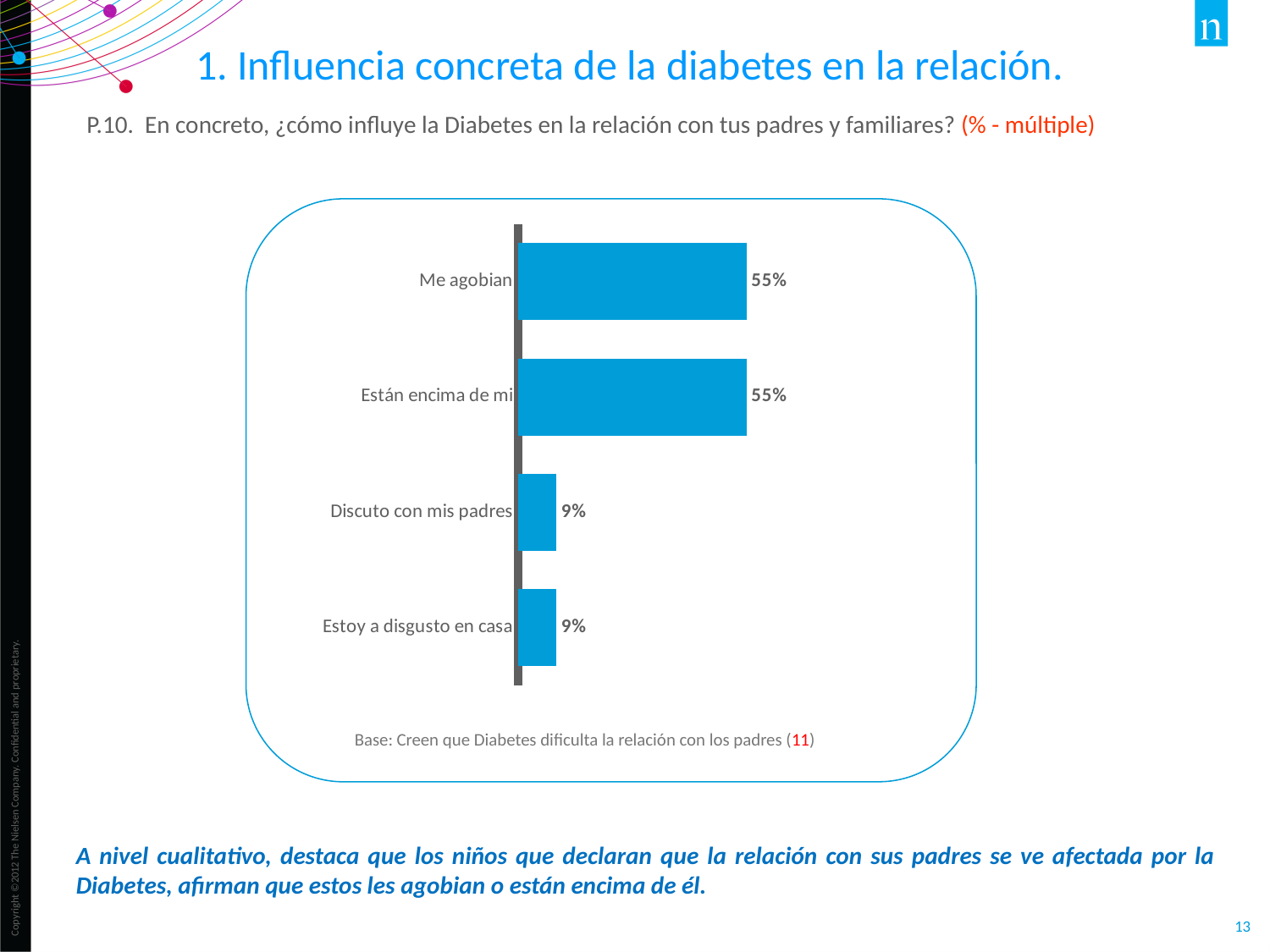
How many categories are shown in the chart? 4 What is the value for "Están encima de mi"? 55% What is the value for "Me agobian"? 55% Which categories share the lowest value in the chart? Discuto con mis padres and Estoy a disgusto en casa What is the value for "Estoy a disgusto en casa"? 9% What colour are the bars in the chart? Blue What kind of chart is shown on the slide? Bar chart Which categories share the highest value in the chart? Me agobian and Están encima de mi What is the base size stated below the chart? 11 What is the difference between the values for "Me agobian" and "Discuto con mis padres"? 46% Which is larger, the value for "Están encima de mi" or the value for "Estoy a disgusto en casa"? Están encima de mi What is the value for "Discuto con mis padres"? 9%